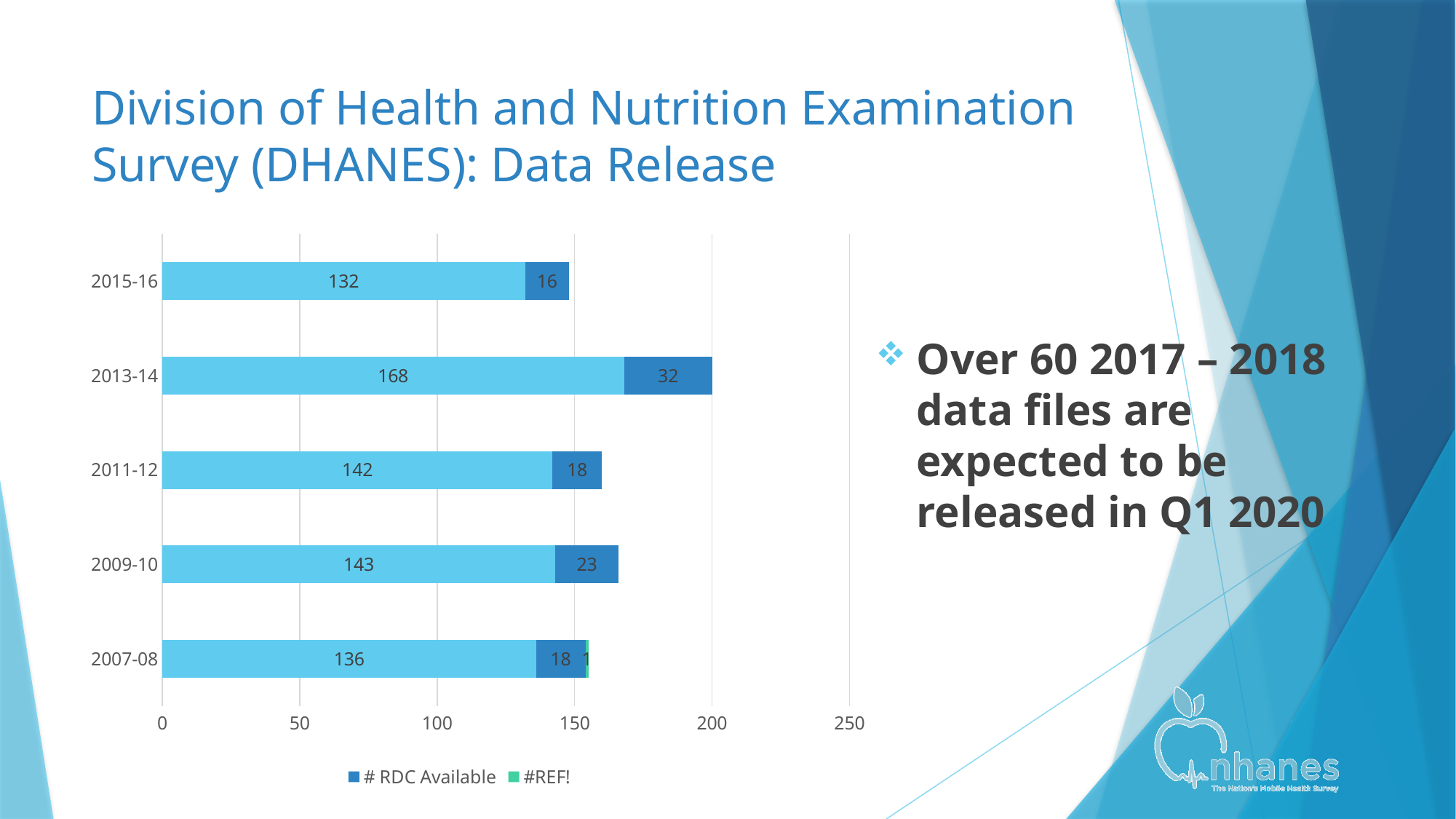
Which has a larger # RDC Available value, 2009-10 or 2011-12? 2009-10 What is the #REF! value shown for 2007-08? 1 How many survey cycles are shown on the chart? 5 What is the value of the light blue segment for 2011-12? 142 Which survey cycle has the highest # RDC Available value? 2013-14 How many series does the legend list? 2 What is the total of the stacked bar for 2013-14? 200 What is the # RDC Available value for 2013-14? 32 What are the two entries listed in the chart legend? # RDC Available and #REF! What kind of chart is shown on the slide? Stacked bar chart Which survey cycle has the lowest # RDC Available value? 2015-16 What is the difference between the light blue segment values for 2013-14 and 2015-16? 36